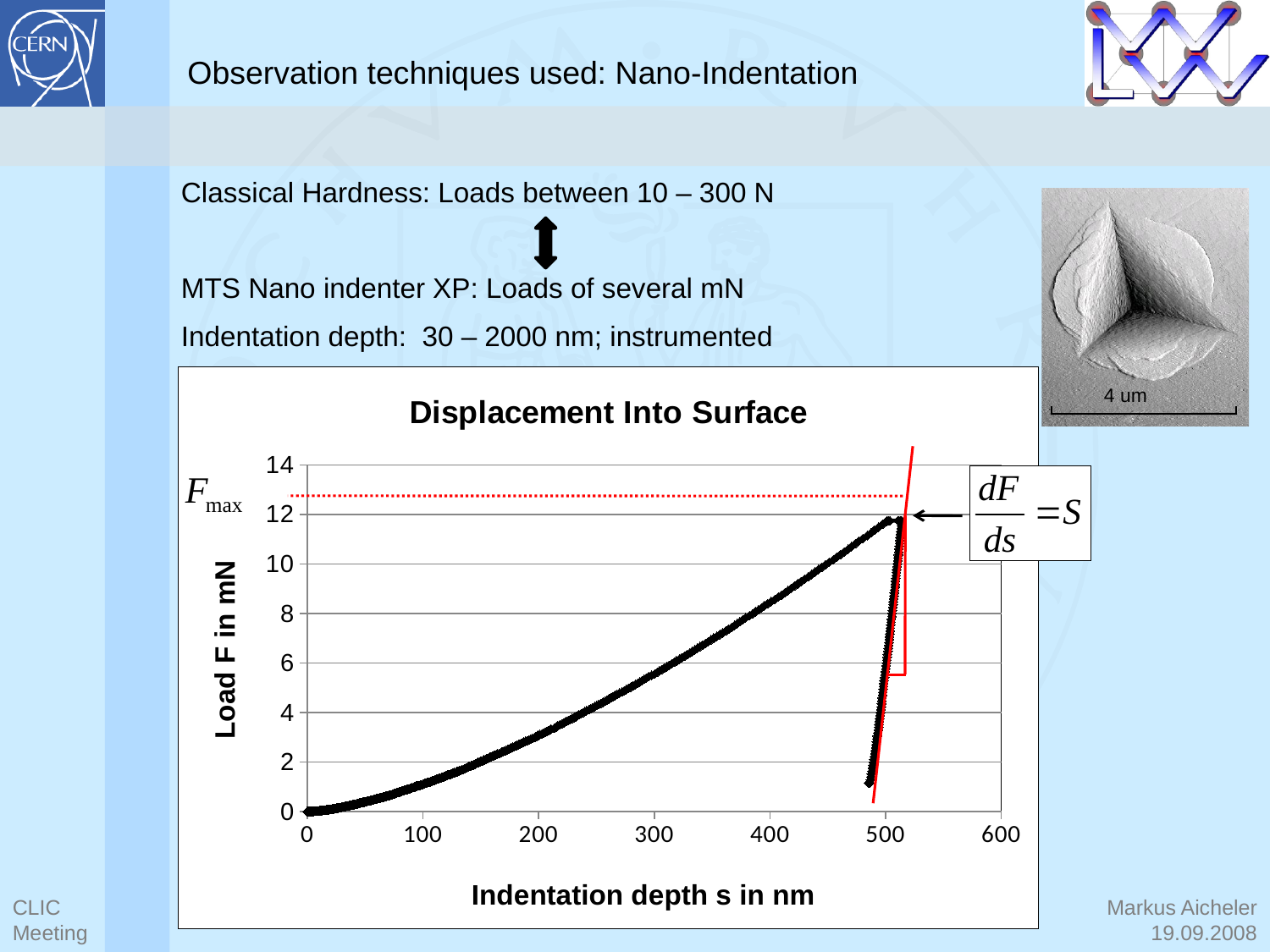
Is the load at an indentation depth of 200 nm greater or less than 4 mN? less What kind of chart is shown on the slide? line chart What is the label of the vertical axis of the chart? Load F in mN Is the load at an indentation depth of 100 nm greater or less than 2 mN? less What is the title of the chart? Displacement Into Surface Is the maximum load reached by the curve greater or less than 14 mN? less During the loading part of the curve, does the load rise or fall as the indentation depth increases? rises What is the highest value shown on the x axis of the chart? 600 How many tick labels are shown on the x axis of the chart? 7